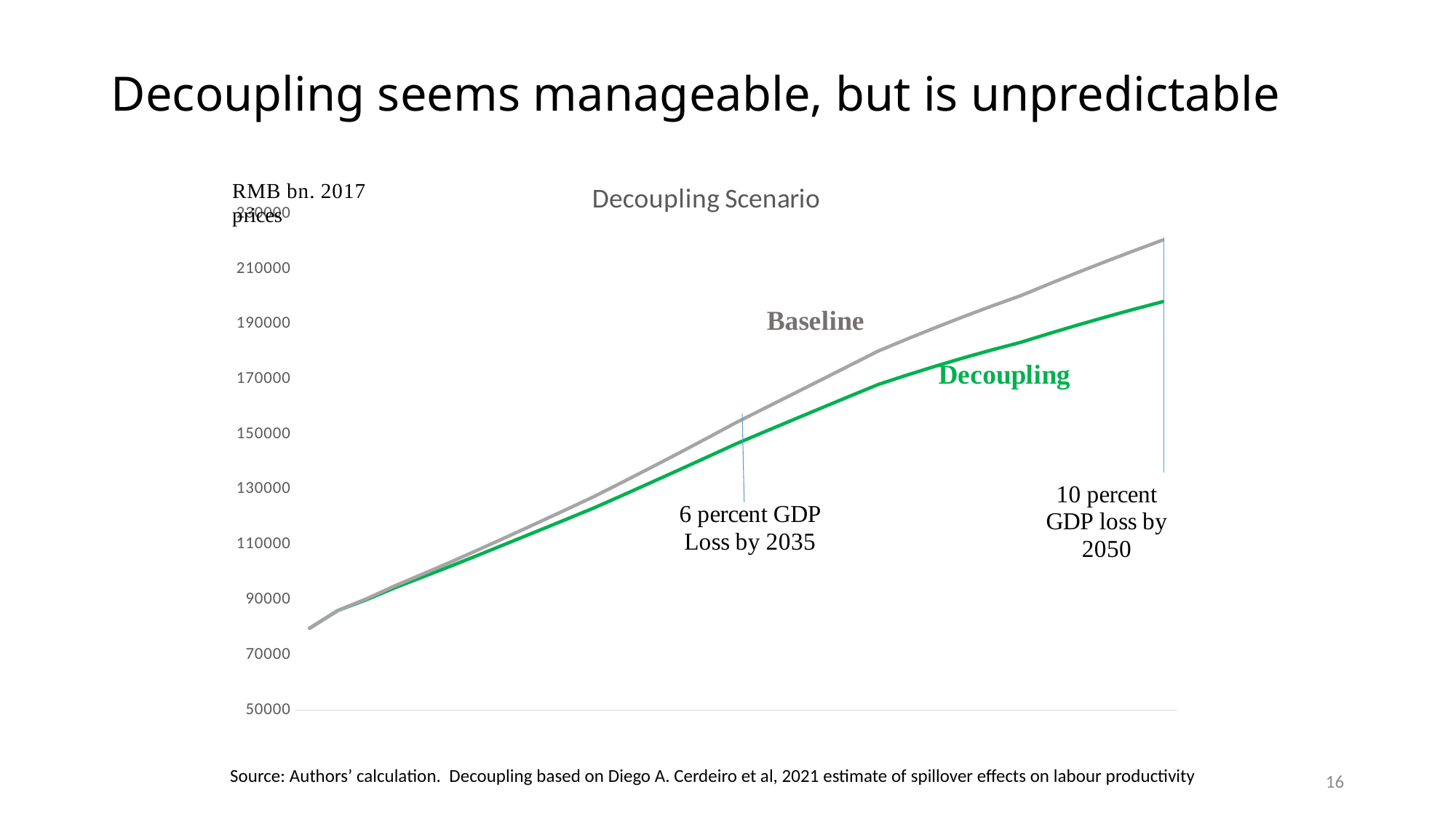
Is the final value of the Decoupling line greater or less than 210000? less What is the title of the chart? Decoupling Scenario What is the lowest value shown on the vertical axis? 50000 Is the final value of the Baseline line greater or less than 210000? greater Do the Baseline and Decoupling lines rise or fall from left to right? rise How many series (lines) are plotted in the chart? 2 Is the starting value of the Baseline line greater or less than 90000? less What kind of chart is shown on the slide? line chart According to the annotation, what is the GDP loss by 2050 under the Decoupling scenario? 10 percent At the right-hand end of the chart, which line is higher, Baseline or Decoupling? Baseline What colour is the Decoupling line? green According to the annotation, what is the GDP loss by 2035 under the Decoupling scenario? 6 percent